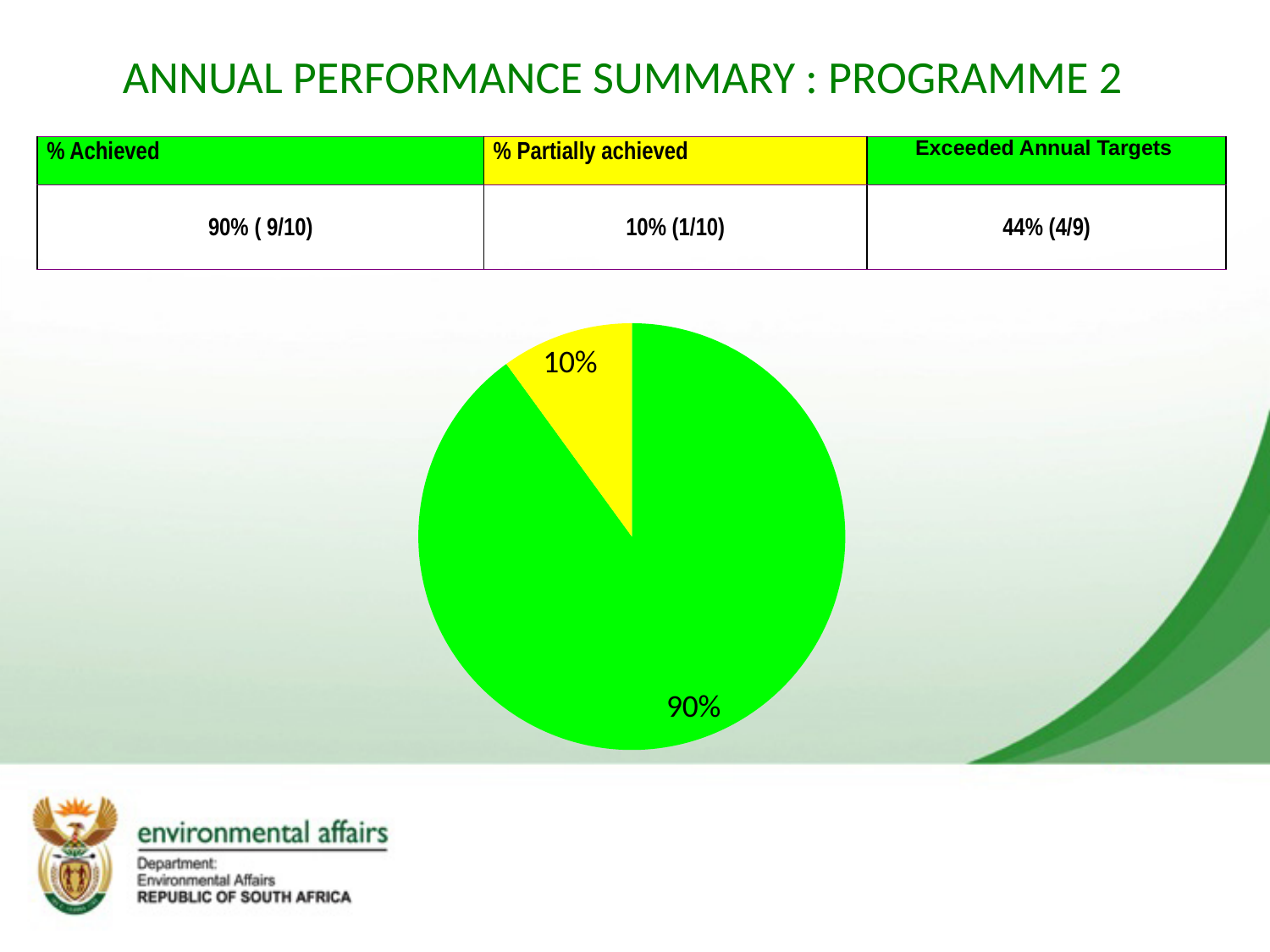
How many slices does the pie chart have? 2 What do the two slices of the pie chart add up to? 100% Which slice of the pie chart is the smallest? the yellow slice (10%) Which is larger, the green slice or the yellow slice? the green slice What kind of chart is shown on the slide? pie chart Is the share of the yellow slice greater or less than 50%? less According to the table above the chart, what category does the yellow colour represent? % Partially achieved What share of the pie does the green slice represent? 90% What share of the pie does the yellow slice represent? 10% Which slice of the pie chart is the largest? the green slice (90%) What is the difference in percentage points between the green slice and the yellow slice? 80 percentage points Which colour is used for the 90% slice of the pie chart? green